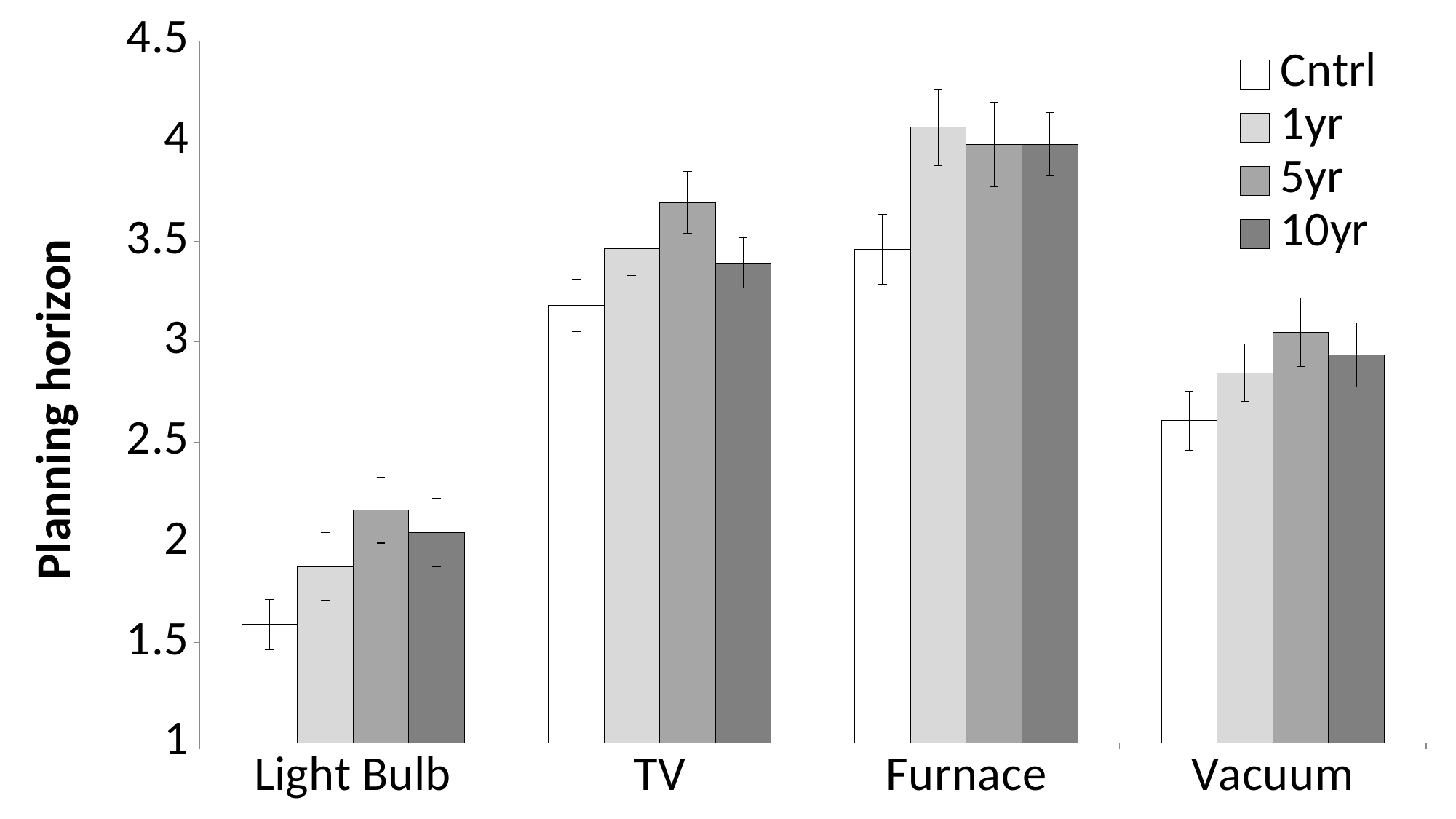
Is the Cntrl value for Light Bulb greater or less than 2? less What is the title of the y axis? Planning horizon Which product category has the highest Cntrl value? Furnace What kind of chart is shown on the slide? bar chart Is the Cntrl value for TV greater or less than 3? greater Is the Cntrl value for Vacuum greater or less than 2.5? greater How many product categories are shown on the x axis? 4 Which product category has the lowest Cntrl value? Light Bulb What are the four legend entries? Cntrl, 1yr, 5yr, 10yr How many series does the legend list? 4 For TV, which series has the highest planning horizon? 5yr